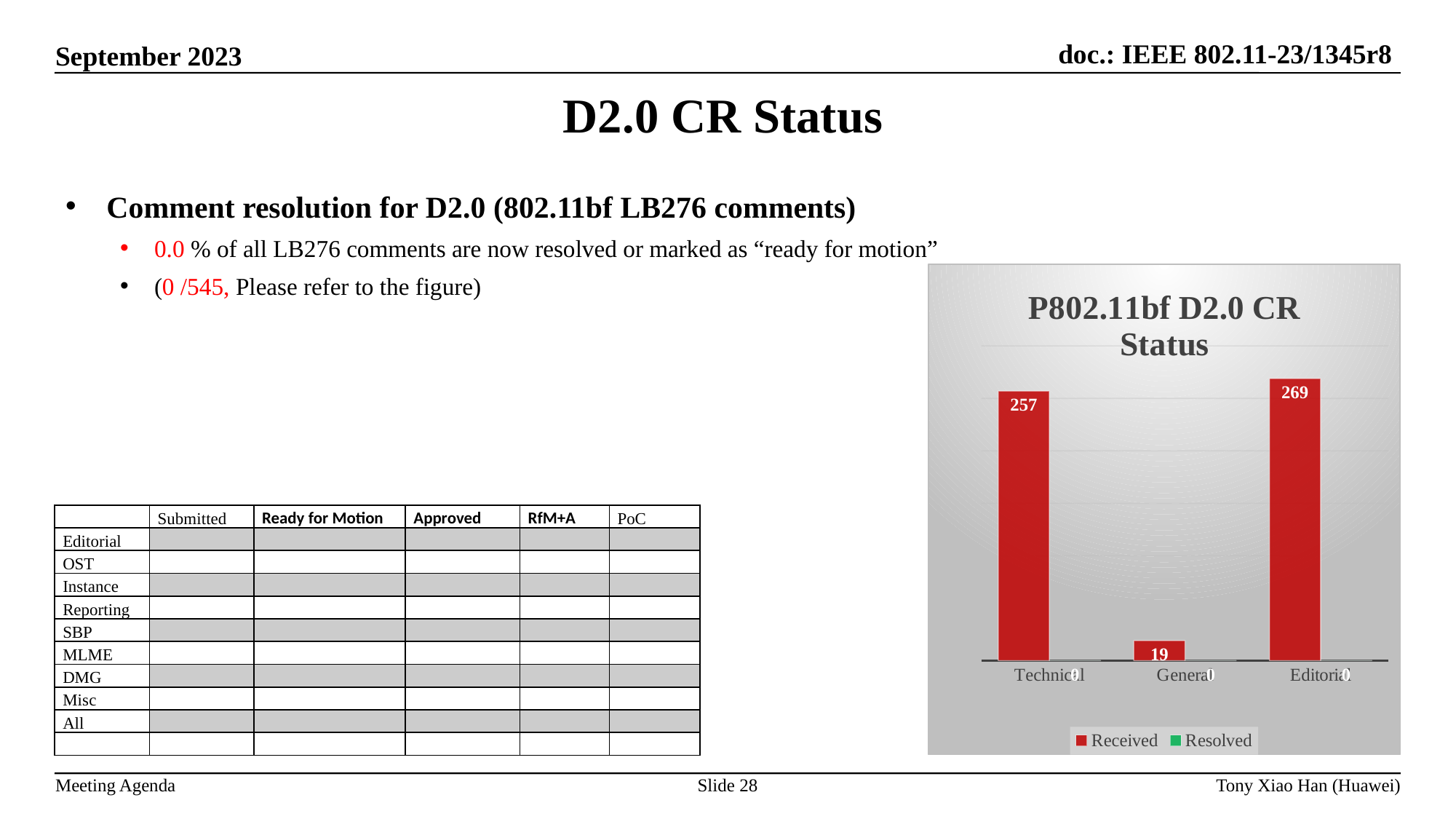
What is the difference between the Received values for Editorial and Technical? 12 What is the Received value for Editorial? 269 What is the Received value for Technical? 257 What are the two series named in the chart legend? Received and Resolved How many series does the chart legend list? 2 Which is larger, the Received value for Technical or for General? Technical What type of chart is shown on the slide? bar chart Which category has the lowest Received value? General How many categories are shown on the x axis of the chart? 3 Which category has the highest Received value? Editorial What is the Received value for General? 19 What is the title of the chart on the slide? P802.11bf D2.0 CR Status